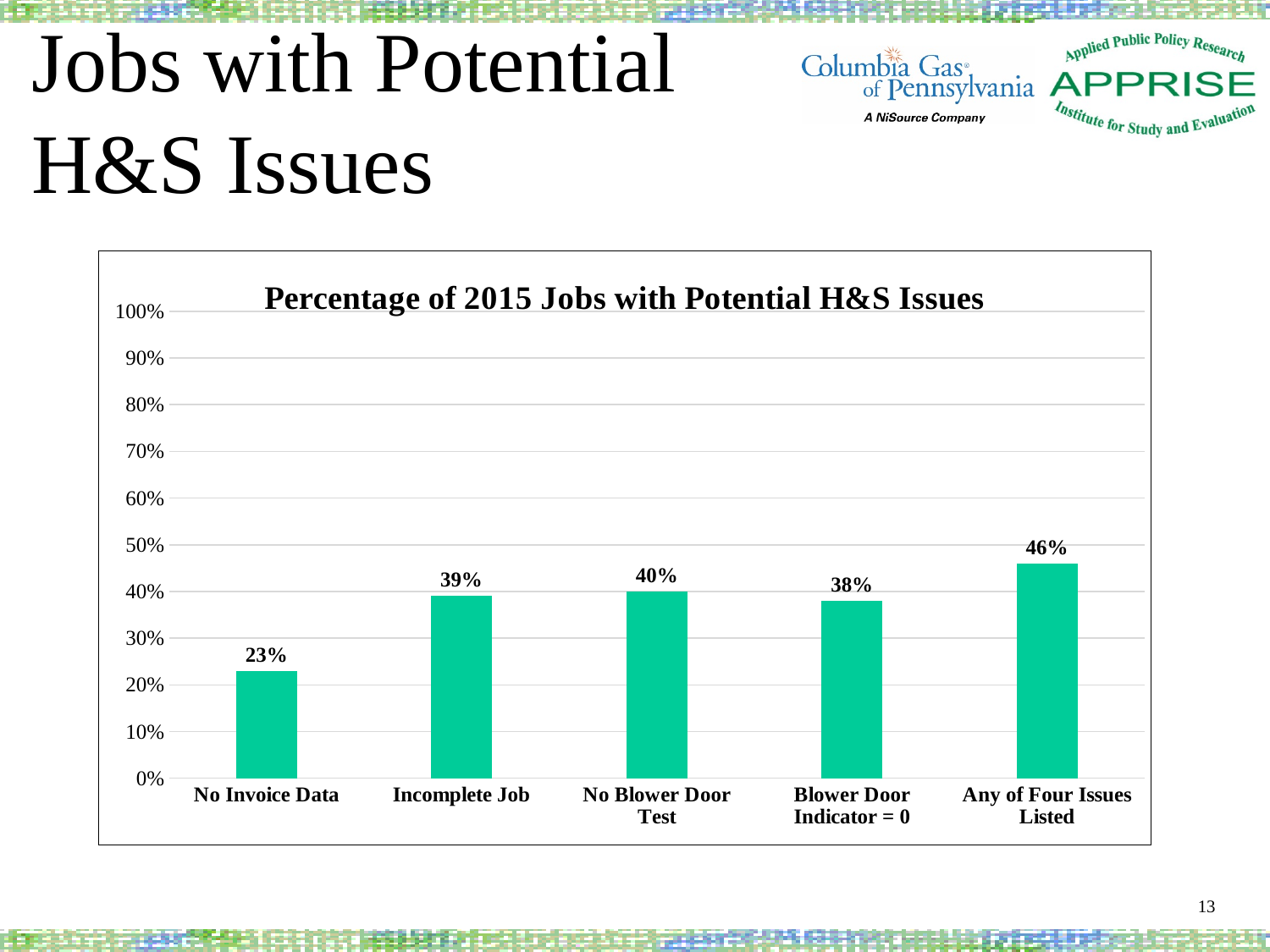
What kind of chart is shown on the slide? Bar chart What is the title of the chart? Percentage of 2015 Jobs with Potential H&S Issues What percentage of 2015 jobs had No Invoice Data? 23% What percentage of jobs had No Blower Door Test? 40% Which category has the highest percentage? Any of Four Issues Listed Which is larger, the value for Incomplete Job or the value for Blower Door Indicator = 0? Incomplete Job What percentage of jobs had Any of Four Issues Listed? 46% How many categories are shown on the x axis? 5 Which category has the lowest percentage? No Invoice Data What is the difference between the values for Any of Four Issues Listed and No Invoice Data? 23% What is the value for Blower Door Indicator = 0? 38% What is the value shown for Incomplete Job? 39%